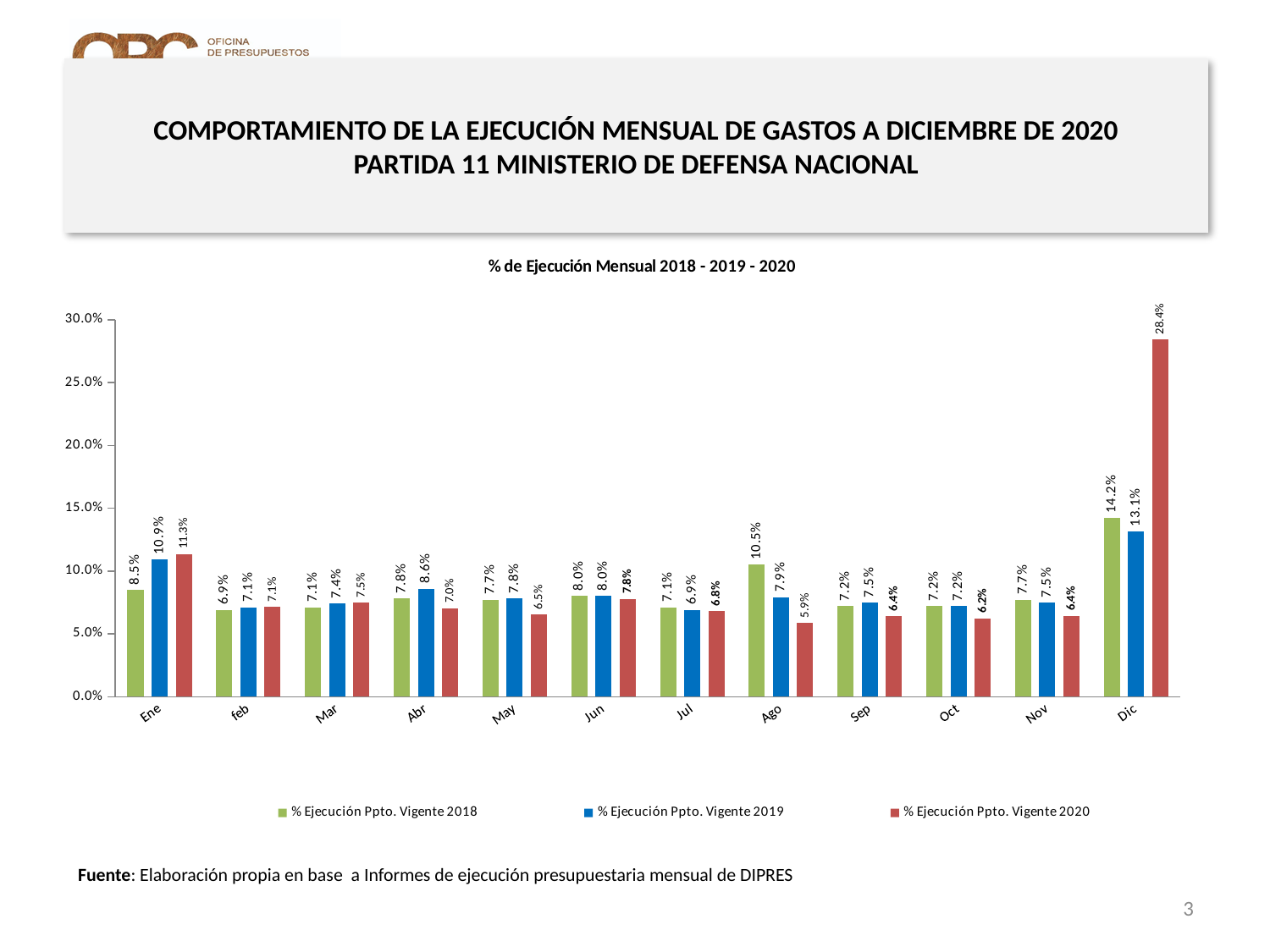
For Abr, which series has the larger value: % Ejecución Ppto. Vigente 2019 or % Ejecución Ppto. Vigente 2020? % Ejecución Ppto. Vigente 2019 What is the value for Dic in the % Ejecución Ppto. Vigente 2020 series? 28.4% What is the difference between the 2020 and 2019 values for Dic? 15.3% How many months are shown on the x axis? 12 What is the value for Ene in the % Ejecución Ppto. Vigente 2019 series? 10.9% How many series does the legend list? 3 What kind of chart is shown? Bar chart What is the value for Ago in the % Ejecución Ppto. Vigente 2018 series? 10.5% Which month has the highest value in the % Ejecución Ppto. Vigente 2020 series? Dic Is the value for Dic in the % Ejecución Ppto. Vigente 2020 series greater or less than 25.0%? greater Which month has the lowest value in the % Ejecución Ppto. Vigente 2020 series? Ago What is the title of the chart? % de Ejecución Mensual 2018 - 2019 - 2020